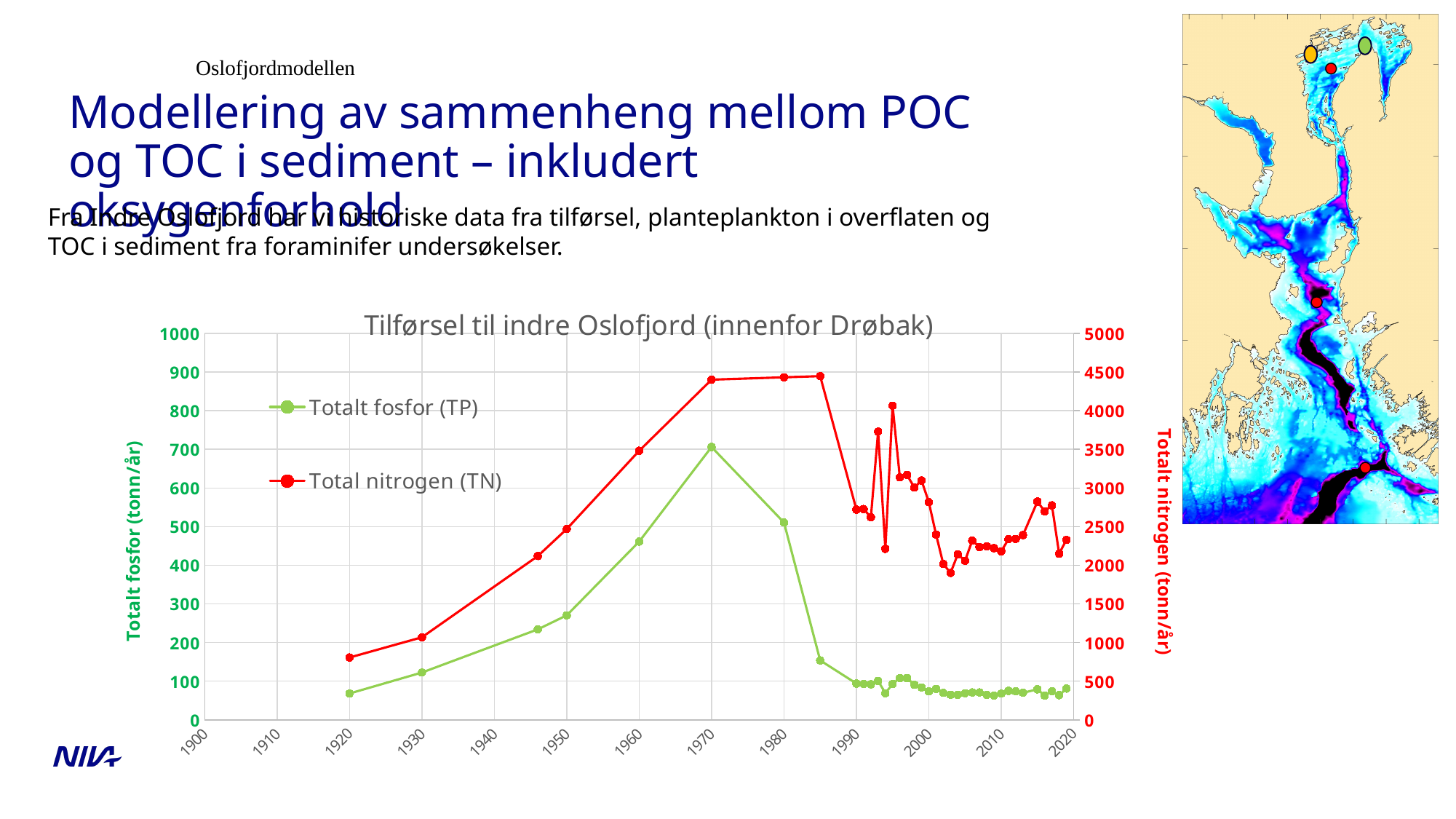
How many series does the legend of the chart list? 2 Is the value for Totalt fosfor (TP) around 1960 greater or less than 500 on the left axis? less In which decade does the Totalt fosfor (TP) series reach its highest value? 1970 What kind of chart is shown on the slide? Line chart Is the value for Total nitrogen (TN) around 1920 greater or less than 1000 on the right axis? less Does the Totalt fosfor (TP) series rise or fall between 1970 and 1990? Fall Does the Totalt fosfor (TP) series rise or fall between 1920 and 1970? Rise Is the value for Totalt fosfor (TP) around 1970 greater or less than 600 on the left axis? greater What is the title of the chart? Tilførsel til indre Oslofjord (innenfor Drøbak) Which series is drawn in red in the chart? Total nitrogen (TN)